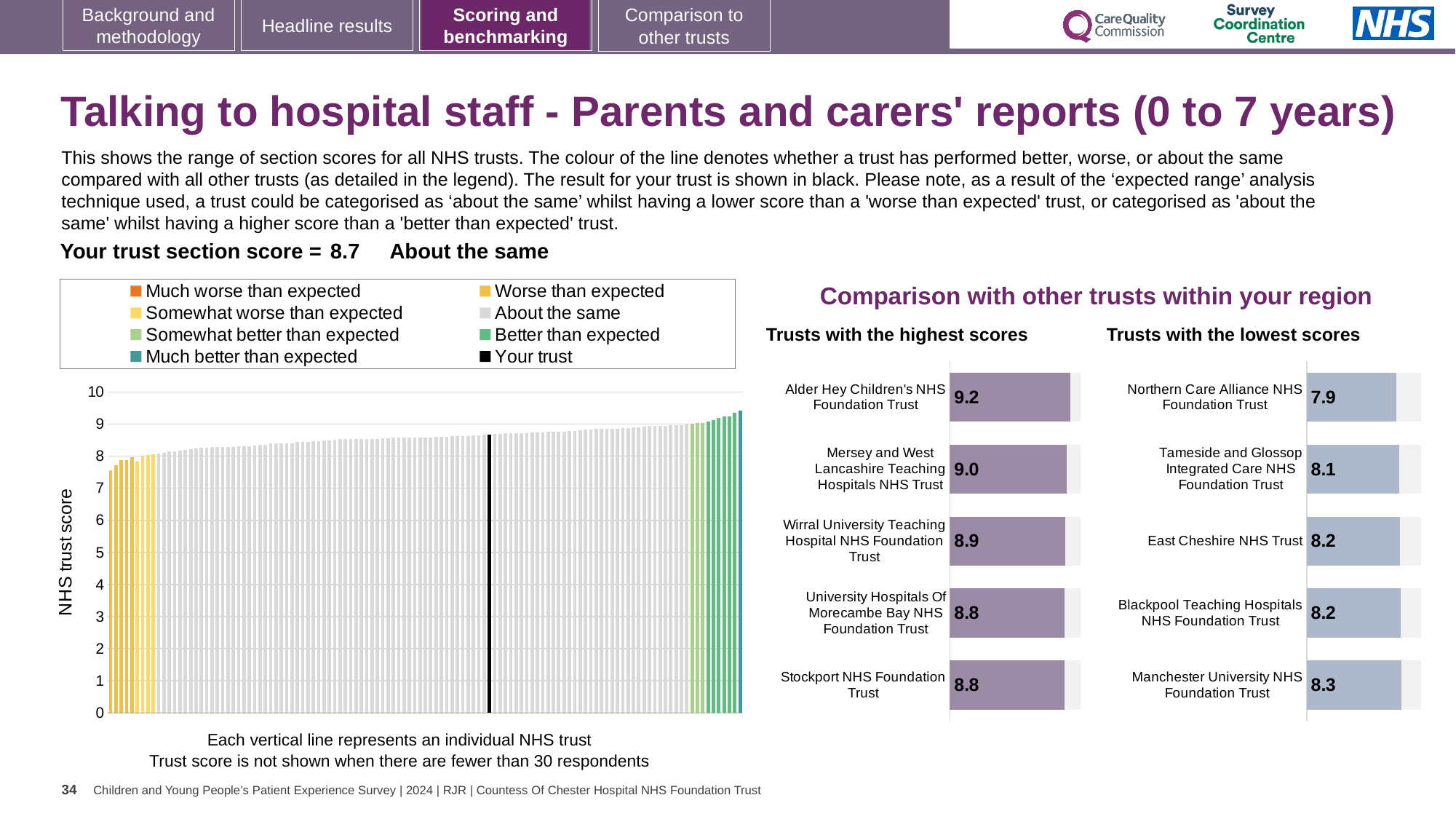
In the 'Trusts with the lowest scores' chart, which trust has the lowest score? Northern Care Alliance NHS Foundation Trust In the 'Trusts with the lowest scores' chart, what is the score for Northern Care Alliance NHS Foundation Trust? 7.9 In the main 'NHS trust score' chart on the left, is the value for your trust (the black line) greater or less than 8? greater How many trusts are listed in the 'Trusts with the highest scores' chart? 5 How many entries does the legend of the main 'NHS trust score' chart list? 8 In the main 'NHS trust score' chart on the left, do the values rise or fall from left to right? Rise In the 'Trusts with the lowest scores' chart, which trust has the highest score? Manchester University NHS Foundation Trust What kind of chart is the main 'NHS trust score' chart on the left? Bar chart In the 'Trusts with the highest scores' chart, what is the score for Wirral University Teaching Hospital NHS Foundation Trust? 8.9 In the 'Trusts with the lowest scores' chart, which has the larger score: Tameside and Glossop Integrated Care NHS Foundation Trust or East Cheshire NHS Trust? East Cheshire NHS Trust In the 'Trusts with the highest scores' chart, what is the difference between the scores of Alder Hey Children's NHS Foundation Trust and Stockport NHS Foundation Trust? 0.4 In the 'Trusts with the highest scores' chart, what is the score for Alder Hey Children's NHS Foundation Trust? 9.2